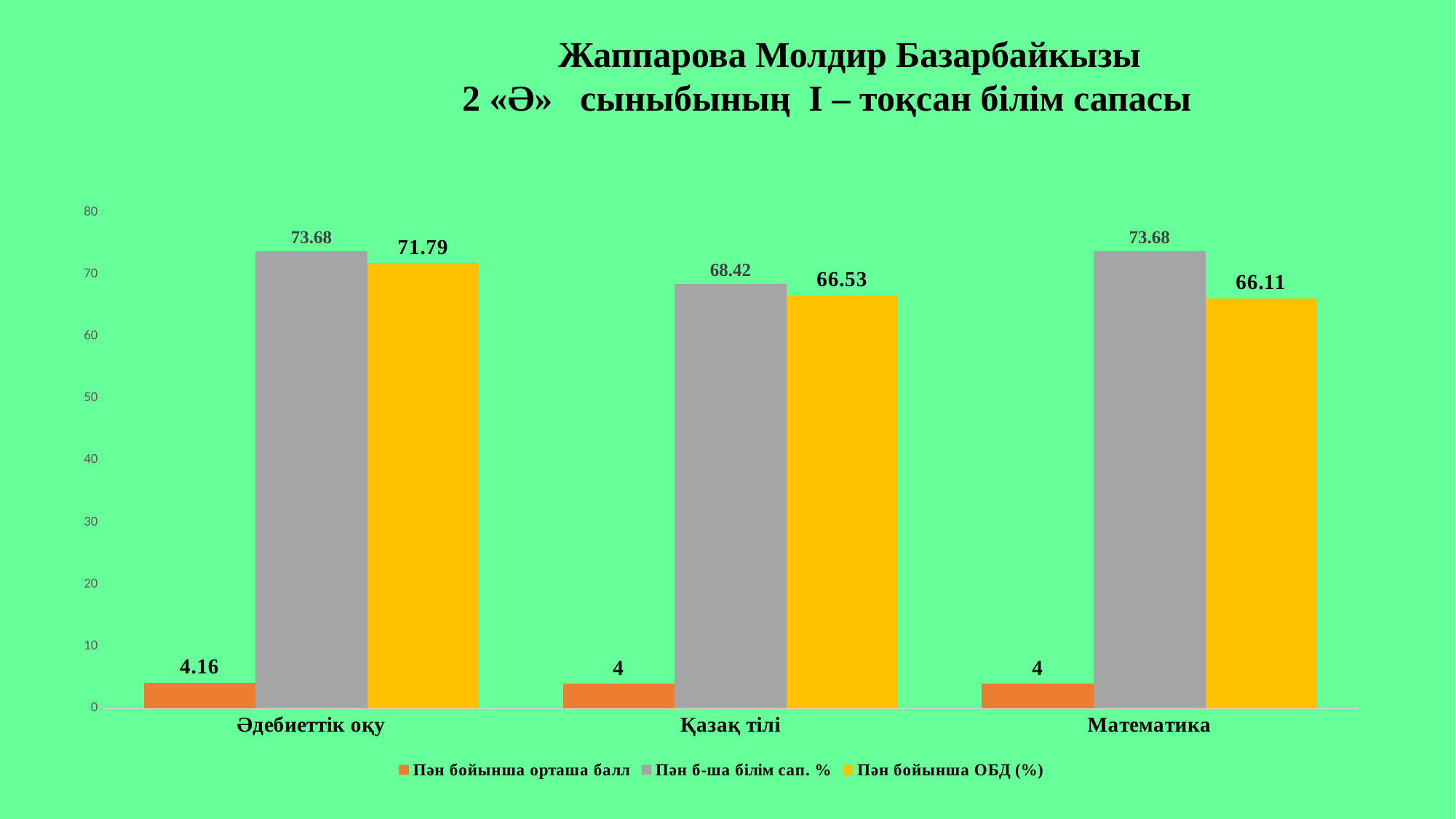
Which colour represents "Пән бойынша орташа балл" in the legend? Orange Is the value of "Пән б-ша білім сап. %" for Математика greater or less than 70? greater Which subject has the lowest value for "Пән б-ша білім сап. %"? Қазақ тілі What kind of chart is shown on the slide? Bar chart How many subjects are shown on the x axis? 3 How many series does the legend list? 3 What is the value of "Пән б-ша білім сап. %" for Қазақ тілі? 68.42 What is the difference between "Пән б-ша білім сап. %" and "Пән бойынша ОБД (%)" for Әдебиеттік оқу? 1.89 What is the value of "Пән бойынша орташа балл" for Әдебиеттік оқу? 4.16 Which is larger: "Пән бойынша ОБД (%)" for Қазақ тілі or for Математика? Қазақ тілі What is the value of "Пән бойынша ОБД (%)" for Математика? 66.11 Which subject has the highest value for "Пән бойынша ОБД (%)"? Әдебиеттік оқу